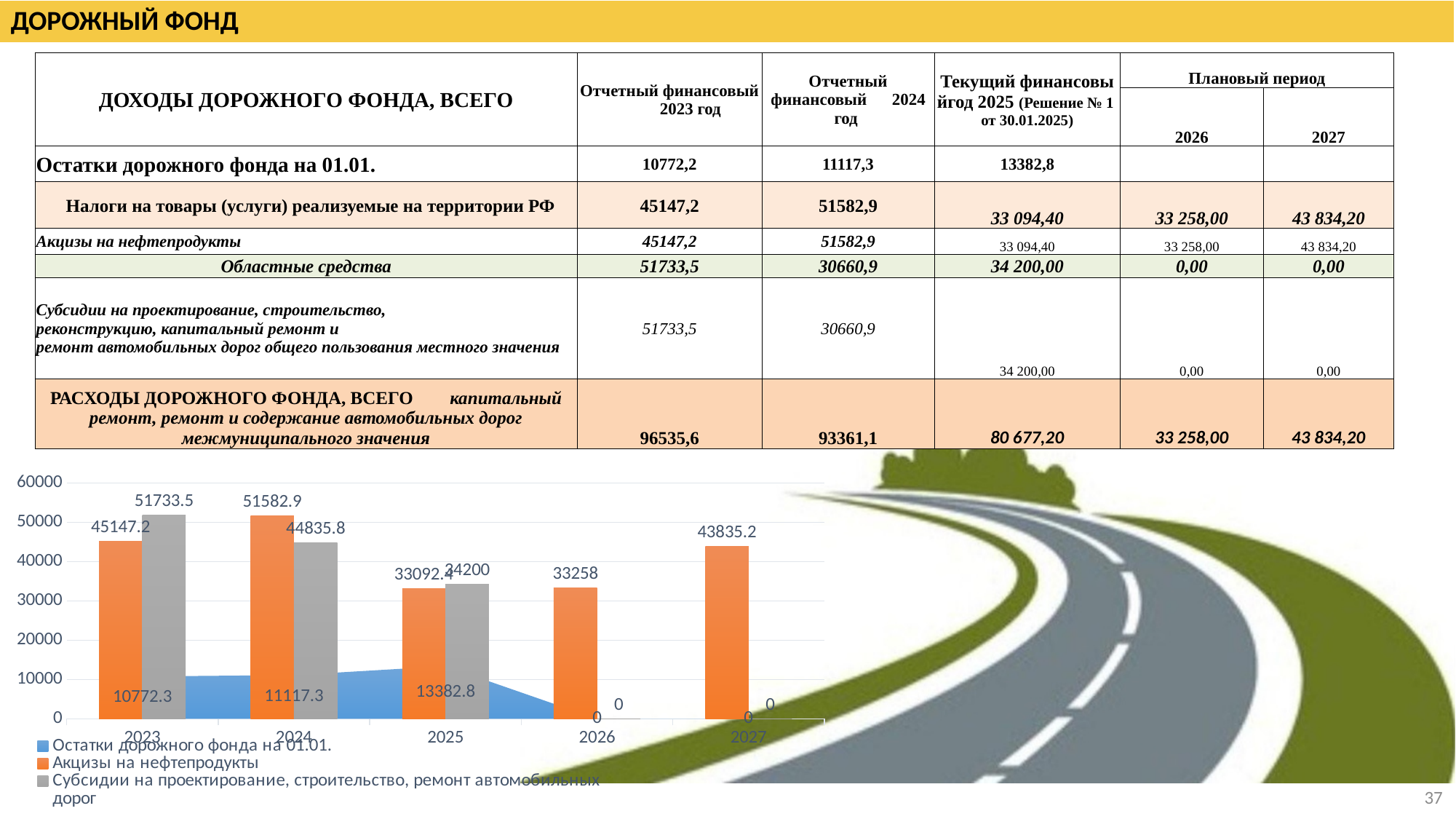
In the chart, what kind of chart is used to show Акцизы на нефтепродукты? bar chart In the chart, what colour represents Остатки дорожного фонда на 01.01.? blue In the chart, what is the value of Акцизы на нефтепродукты for 2024? 51582.9 How many years are shown on the x axis of the chart? 5 In the chart, what is the value of Субсидии на проектирование, строительство, ремонт автомобильных дорог for 2023? 51733.5 In the chart, which is larger in 2024: Акцизы на нефтепродукты or Субсидии на проектирование, строительство, ремонт автомобильных дорог? Акцизы на нефтепродукты In the chart, what is the difference between Субсидии на проектирование, строительство, ремонт автомобильных дорог and Акцизы на нефтепродукты in 2023? 6586.3 In the chart, which year has the highest value for Акцизы на нефтепродукты? 2024 In the chart, what is the value of Акцизы на нефтепродукты for 2027? 43835.2 In the chart, what is the value of Остатки дорожного фонда на 01.01. for 2025? 13382.8 In the chart, which year has the lowest value for Акцизы на нефтепродукты? 2025 How many series does the chart legend list? 3